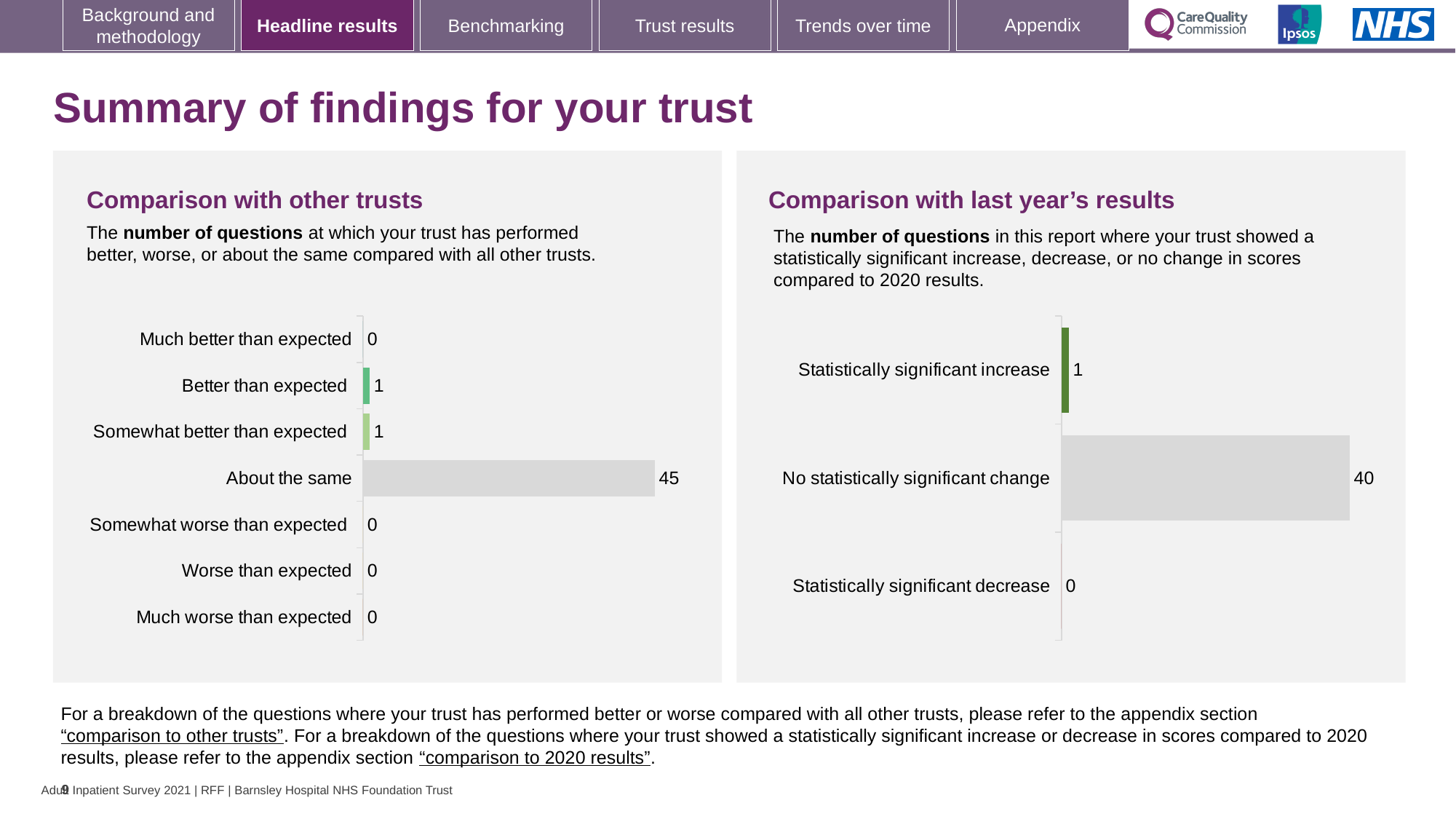
In the 'Comparison with other trusts' chart, what is the total of all the values shown? 47 In the 'Comparison with last year's results' chart, how many categories are shown? 3 In the 'Comparison with last year's results' chart, what is the value for 'No statistically significant change'? 40 In the 'Comparison with other trusts' chart, what is the value for 'Better than expected'? 1 In the 'Comparison with other trusts' chart, which category has the highest value? About the same In the 'Comparison with last year's results' chart, what is the value for 'Statistically significant decrease'? 0 In the 'Comparison with last year's results' chart, what is the value for 'Statistically significant increase'? 1 In the 'Comparison with other trusts' chart, what is the value for 'Much worse than expected'? 0 In the 'Comparison with other trusts' chart, what is the value for 'About the same'? 45 In the 'Comparison with last year's results' chart, what is the difference between 'No statistically significant change' and 'Statistically significant increase'? 39 In the 'Comparison with other trusts' chart, how many categories are shown? 7 What kind of chart is the 'Comparison with other trusts' chart? Bar chart